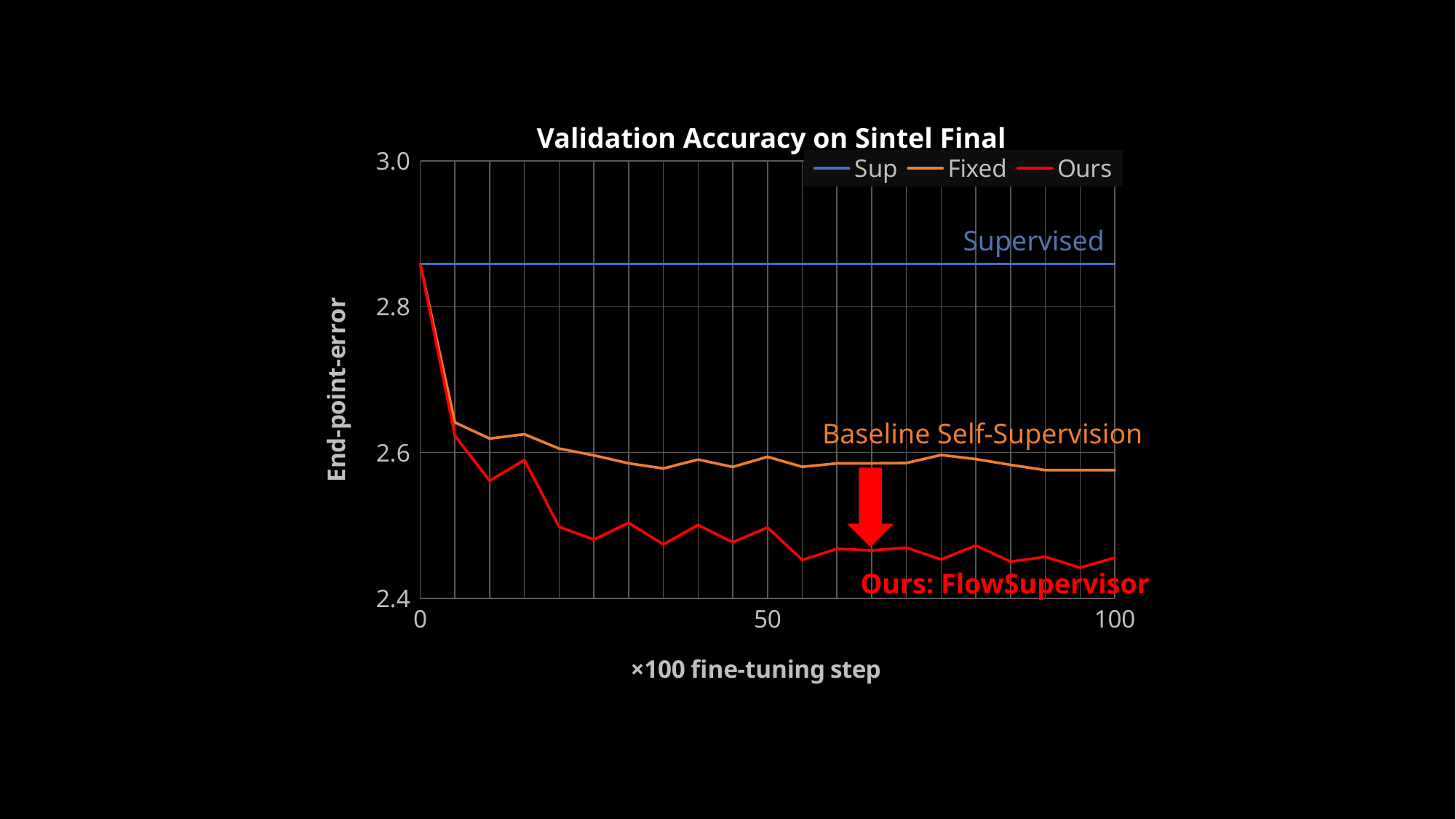
Is the value of the Sup series greater or less than 2.8? greater Which series has the lowest end-point-error at fine-tuning step 100? Ours Is the value of the Ours series at fine-tuning step 0 greater or less than 2.8? greater Which series has the highest end-point-error at fine-tuning step 50? Sup Is the value of the Ours series at fine-tuning step 100 greater or less than 2.6? less What is the title of the chart? Validation Accuracy on Sintel Final At fine-tuning step 100, which series has the larger end-point-error, Fixed or Ours? Fixed What kind of chart is shown on the slide? Line chart What is the label of the y axis? End-point-error Does the Ours series rise or fall overall as the fine-tuning step increases? Fall How many series does the legend list? 3